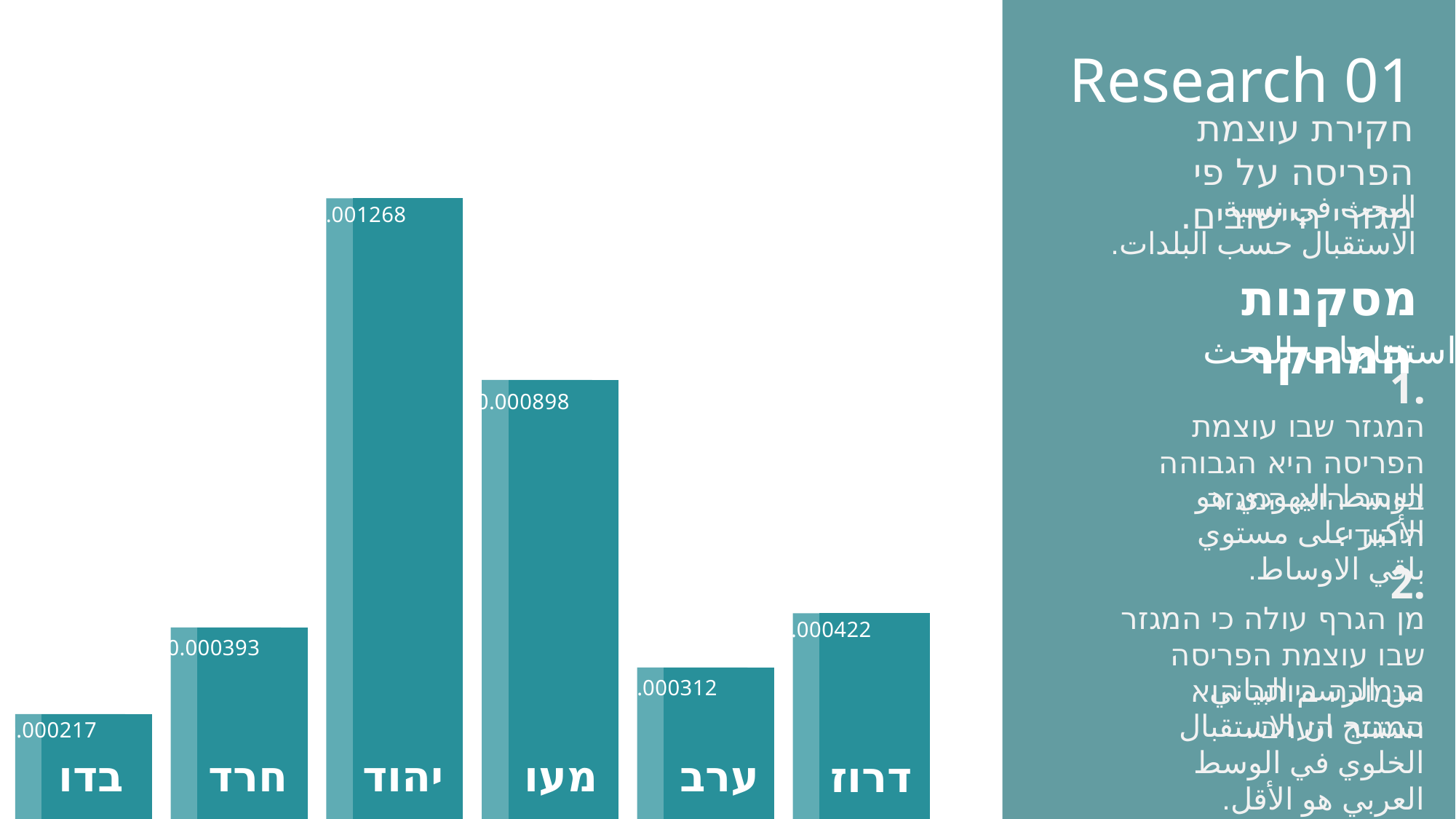
What is the value shown for דרוז? .000422 What is the value shown for מעו? 0.000898 What kind of chart is shown on the slide? bar chart What is the difference between the values for מעו and חרד? 0.000505 What is the value shown for ערב? .000312 Which is larger, the value for חרד or the value for דרוז? דרוז Which category has the highest value in the chart? יהוד What is the value shown for חרד? 0.000393 What is the value shown for יהוד? .001268 How many bars (categories) does the chart show? 6 Which is larger, the value for מעו or the value for ערב? מעו Which category has the lowest value in the chart? בדו